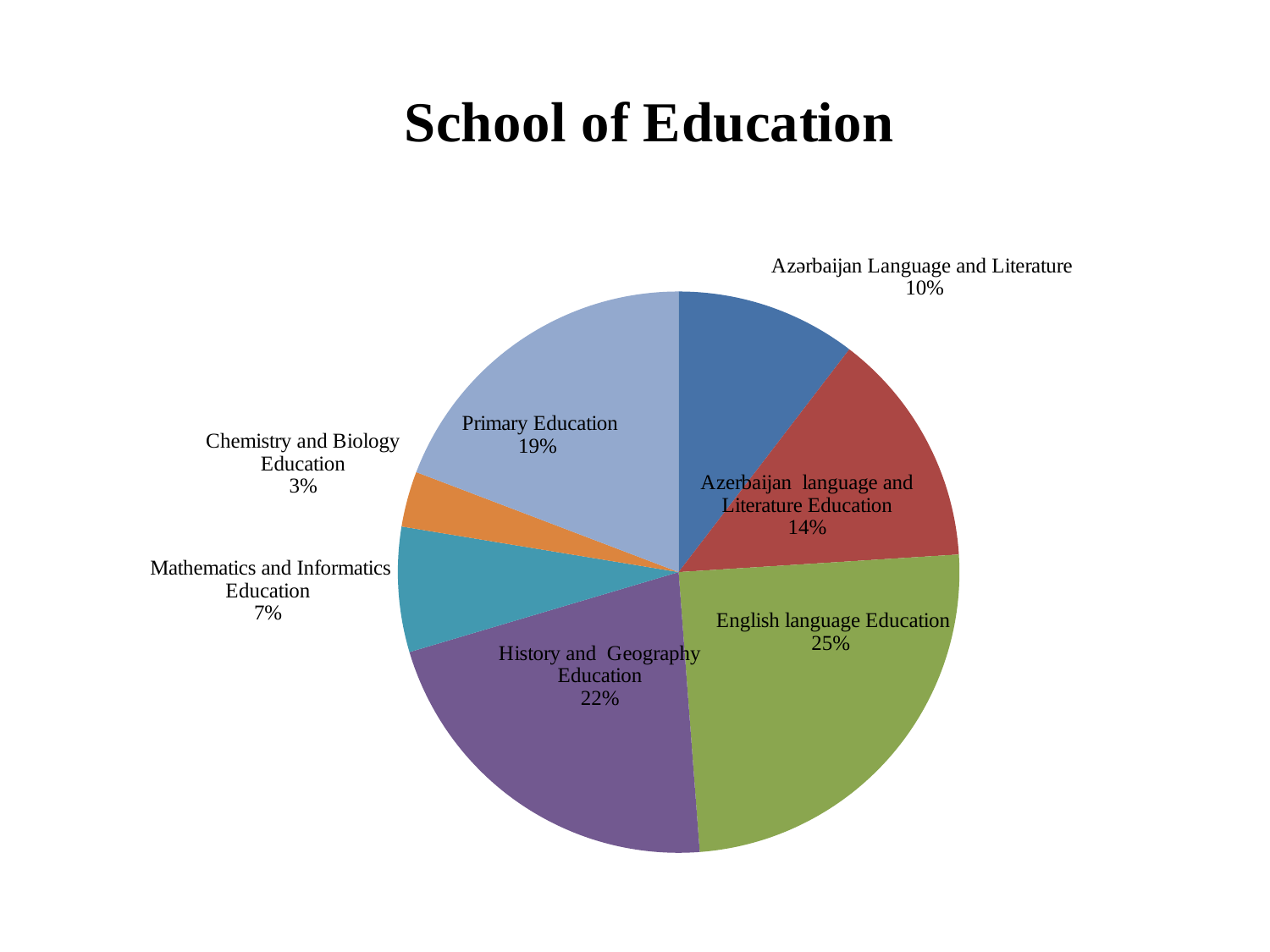
What is the title of the chart? School of Education What is the share for Mathematics and Informatics Education? 7% Which category has the smallest share of the pie? Chemistry and Biology Education How many slices does the pie chart have? 7 What is the share for History and Geography Education? 22% What is the difference in percentage points between English language Education and Primary Education? 6 What kind of chart is shown on the slide? pie chart Which is larger, the share for Azerbaijan language and Literature Education or the share for Azərbaijan Language and Literature? Azerbaijan language and Literature Education Which category has the largest share of the pie? English language Education What is the share for Primary Education? 19% What is the share for Chemistry and Biology Education? 3% What is the share for English language Education? 25%